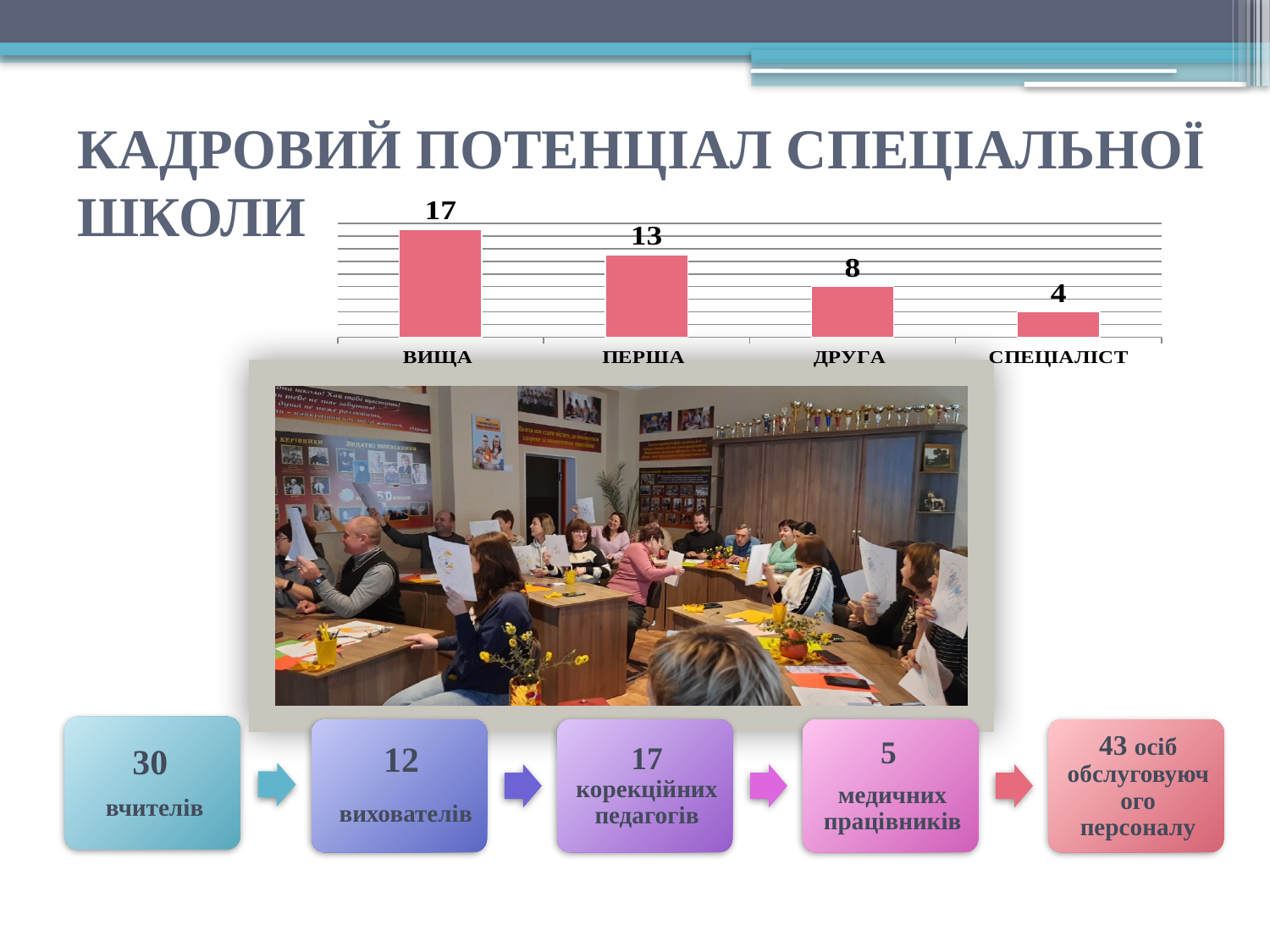
How many categories are shown in the chart? 4 What is the difference between the values for ВИЩА and ПЕРША? 4 What is the value for ПЕРША? 13 What is the difference between the values for ДРУГА and СПЕЦІАЛІСТ? 4 What is the value for СПЕЦІАЛІСТ? 4 Do the values rise or fall from left to right along the x axis? fall Which category has the lowest value? СПЕЦІАЛІСТ What is the value for ВИЩА? 17 Which is larger, the value for ПЕРША or the value for ДРУГА? ПЕРША What kind of chart is shown on the slide? bar chart What is the value for ДРУГА? 8 Which category has the highest value? ВИЩА